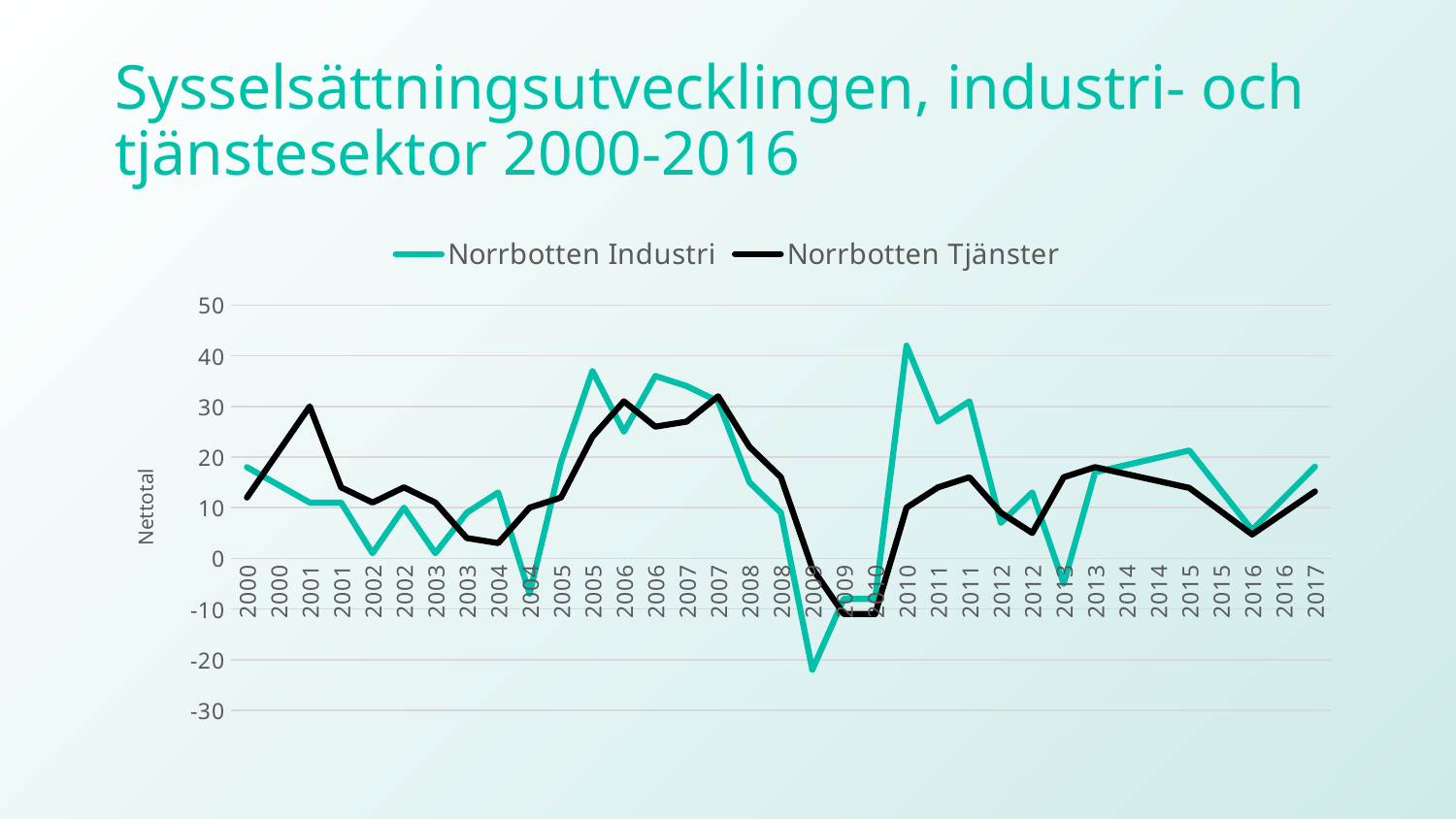
How many series does the legend list? 2 What are the two series named in the legend? Norrbotten Industri and Norrbotten Tjänster At the first 2001 point, which series has the larger value, Norrbotten Industri or Norrbotten Tjänster? Norrbotten Tjänster Is the lowest value of the Norrbotten Industri line greater or less than -20? less Is the highest value of the Norrbotten Industri line greater or less than 40? greater Does the Norrbotten Tjänster line rise or fall between the first 2007 point and the first 2009 point? fall Is the value of Norrbotten Industri at the second 2005 point greater or less than 30? greater At the first 2010 point, which series has the larger value, Norrbotten Industri or Norrbotten Tjänster? Norrbotten Industri What kind of chart is shown on the slide? line chart What is the label on the vertical axis? Nettotal In which year does the Norrbotten Industri line reach its highest value? 2010